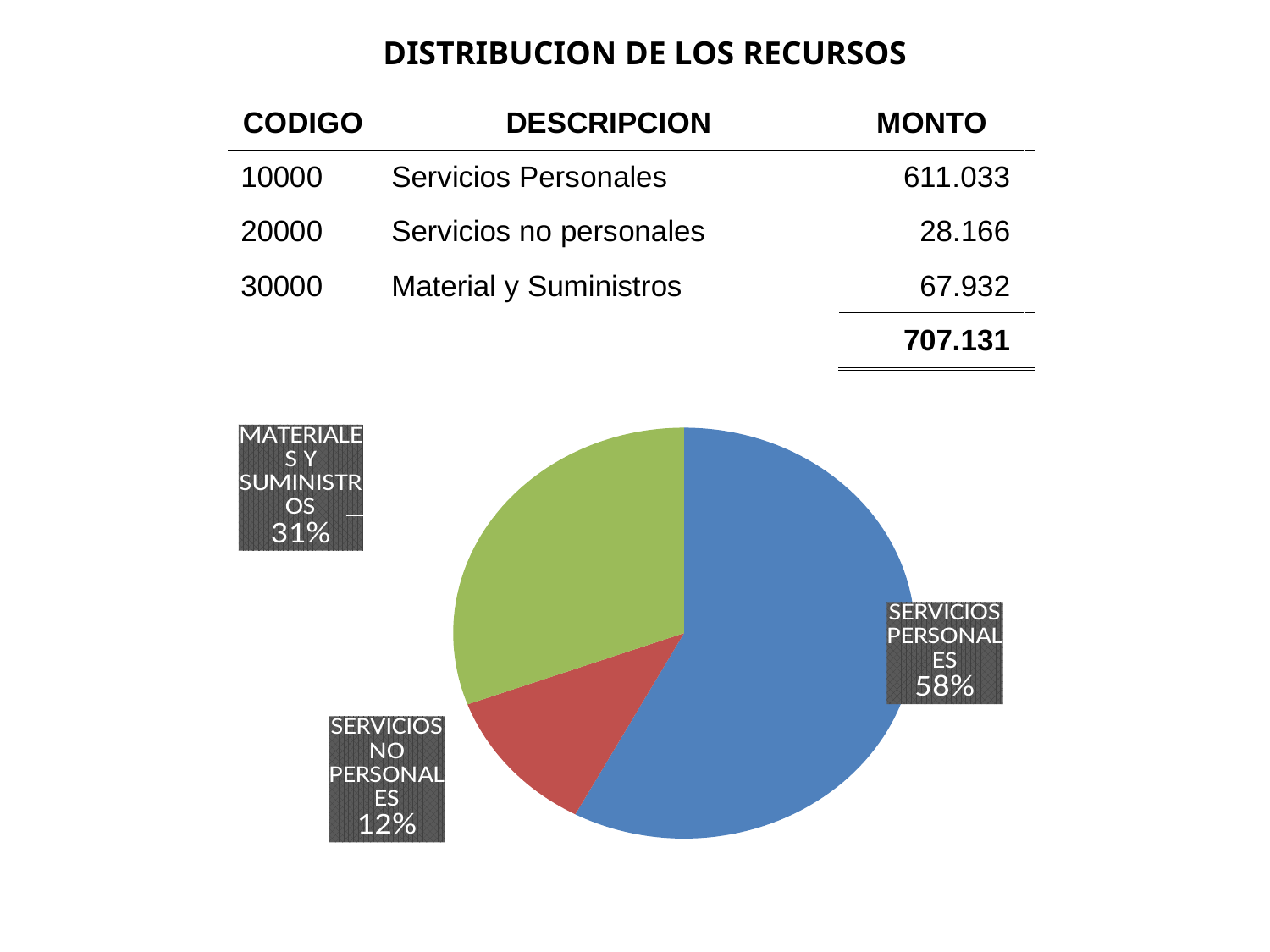
Which is larger in the pie chart, Materiales y Suministros or Servicios No Personales? Materiales y Suministros Which slice of the pie chart is the largest? Servicios Personales By how many percentage points does Materiales y Suministros exceed Servicios No Personales in the pie chart? 19 What share of the pie does Materiales y Suministros represent? 31% What share of the pie does Servicios No Personales represent? 12% What colour is the Servicios Personales slice in the pie chart? blue How many slices does the pie chart have? 3 Which slice of the pie chart is the smallest? Servicios No Personales By how many percentage points does Servicios Personales exceed Materiales y Suministros in the pie chart? 27 What colour is the Materiales y Suministros slice in the pie chart? green What kind of chart is shown on the slide? pie chart What share of the pie does Servicios Personales represent? 58%